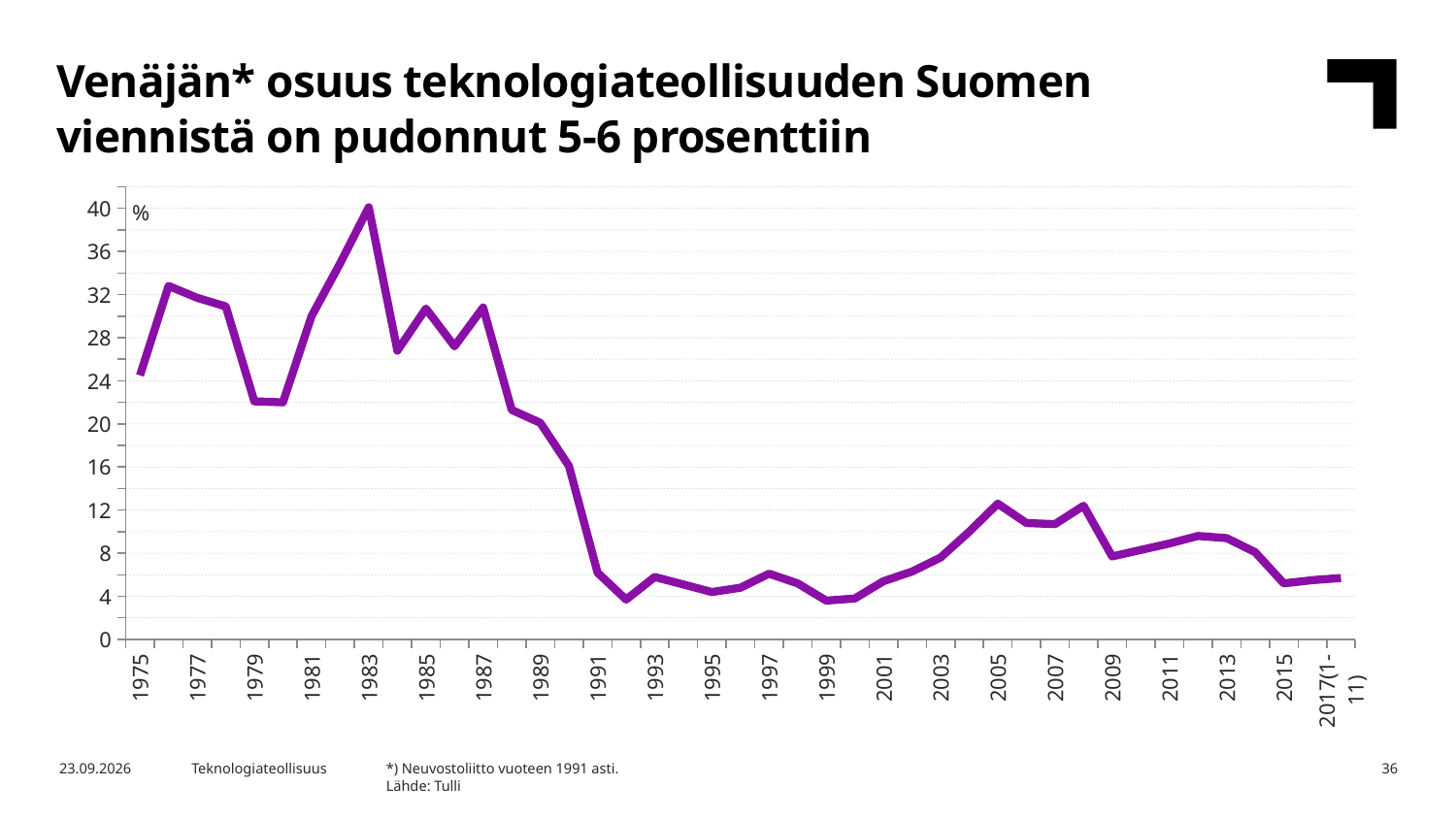
What kind of chart is shown on the slide? line chart Is the value for 1983 greater or less than 36? greater What unit is shown at the top of the vertical axis? % Is the value for 1979 greater or less than 24? less Overall, do the values rise or fall from 1975 to 2017(1-11)? fall Is the value for 1989 greater or less than 16? greater In which year does the line reach its highest value? 1983 Which is larger, the value for 1983 or the value for 2005? 1983